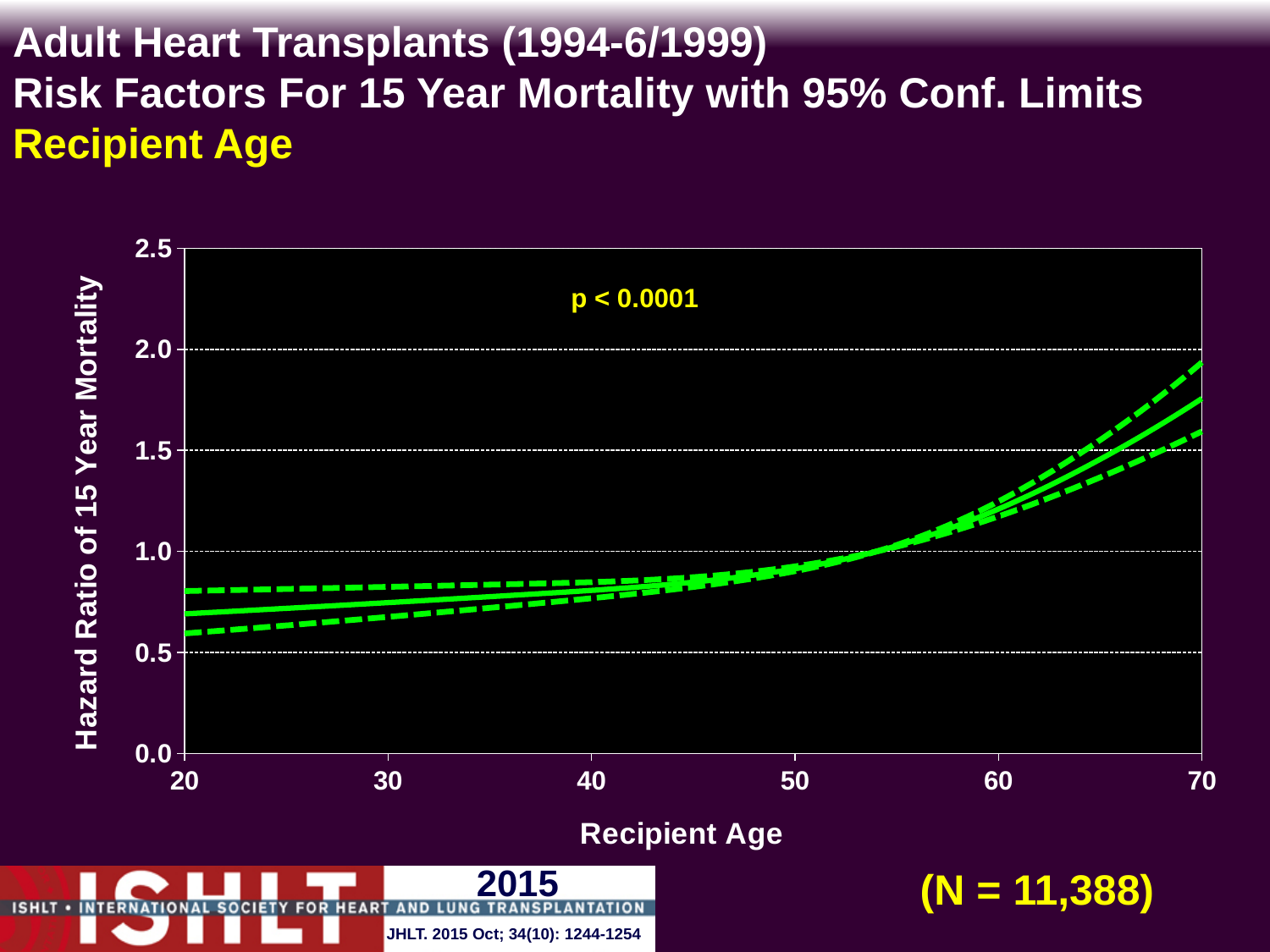
Is the hazard ratio (solid line) at recipient age 20 greater or less than 1.0? less Does the hazard ratio of 15 year mortality rise or fall as recipient age increases from 20 to 70? rise Is the hazard ratio (solid line) at recipient age 40 greater or less than 1.0? less Is the hazard ratio (solid line) at recipient age 60 greater or less than 1.0? greater How many lines are plotted on the chart (the estimate plus its confidence limits)? 3 What is the sample size (N) shown on the slide? N = 11,388 What kind of chart is shown on the slide? line chart Which recipient age has the larger hazard ratio on the solid line, 20 or 70? 70 What p-value is printed on the chart? p < 0.0001